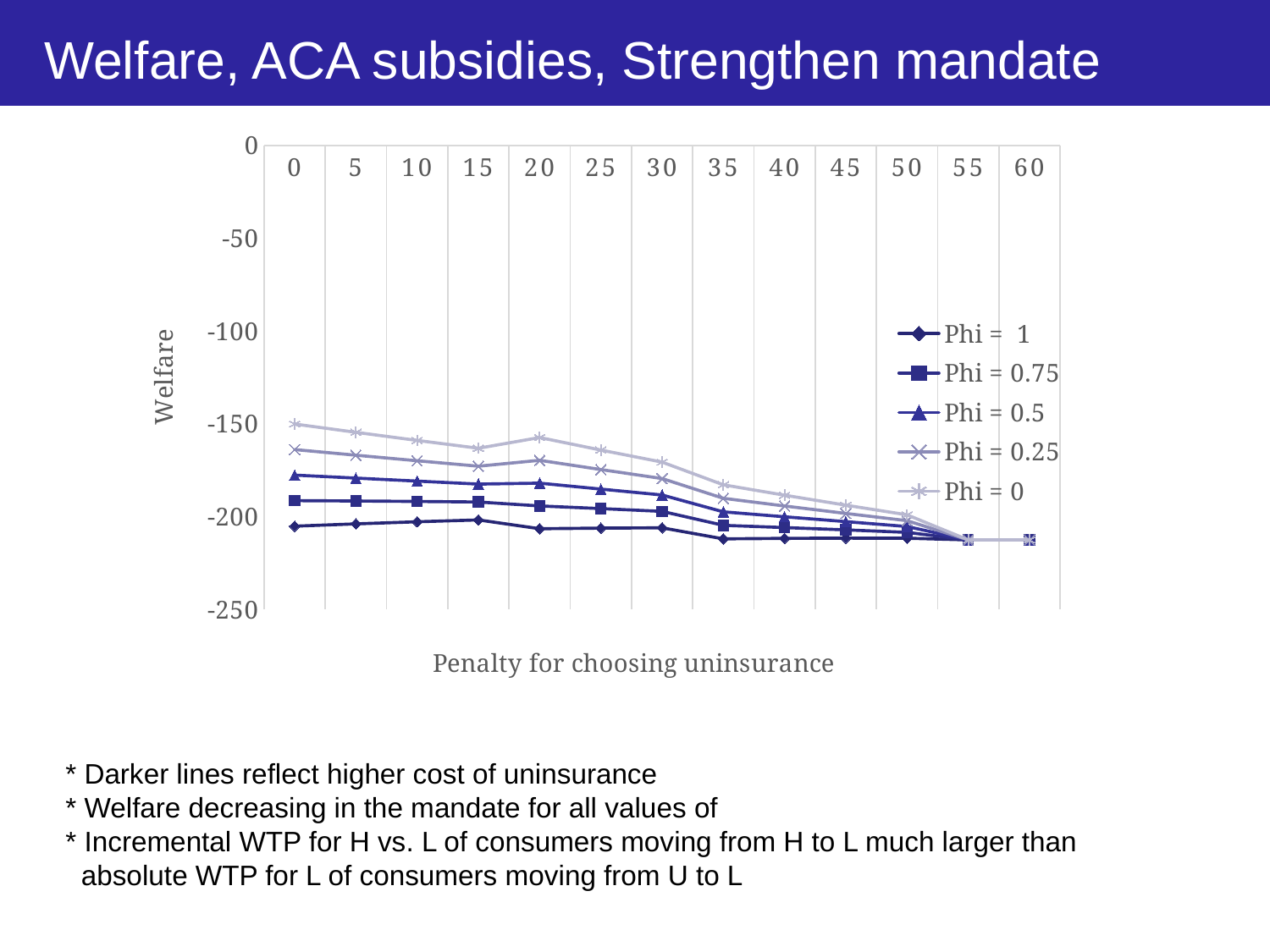
What is the title of the x axis? Penalty for choosing uninsurance How many series does the legend list? 5 What kind of chart is shown on the slide? line chart What is the title of the y axis? Welfare Is the welfare value for Phi = 0.25 at a penalty of 0 greater or less than -150? less At a penalty of 20, is welfare higher for Phi = 0 or for Phi = 1? Phi = 0 Is the welfare value for Phi = 0.75 at a penalty of 0 greater or less than -200? greater How many penalty values are plotted along the x axis? 13 Does welfare rise or fall as the penalty for choosing uninsurance increases? fall At a penalty of 0, which series has the highest welfare? Phi = 0 At a penalty of 0, which series has the lowest welfare? Phi = 1 Is the welfare value for Phi = 1 at a penalty of 35 greater or less than -200? less